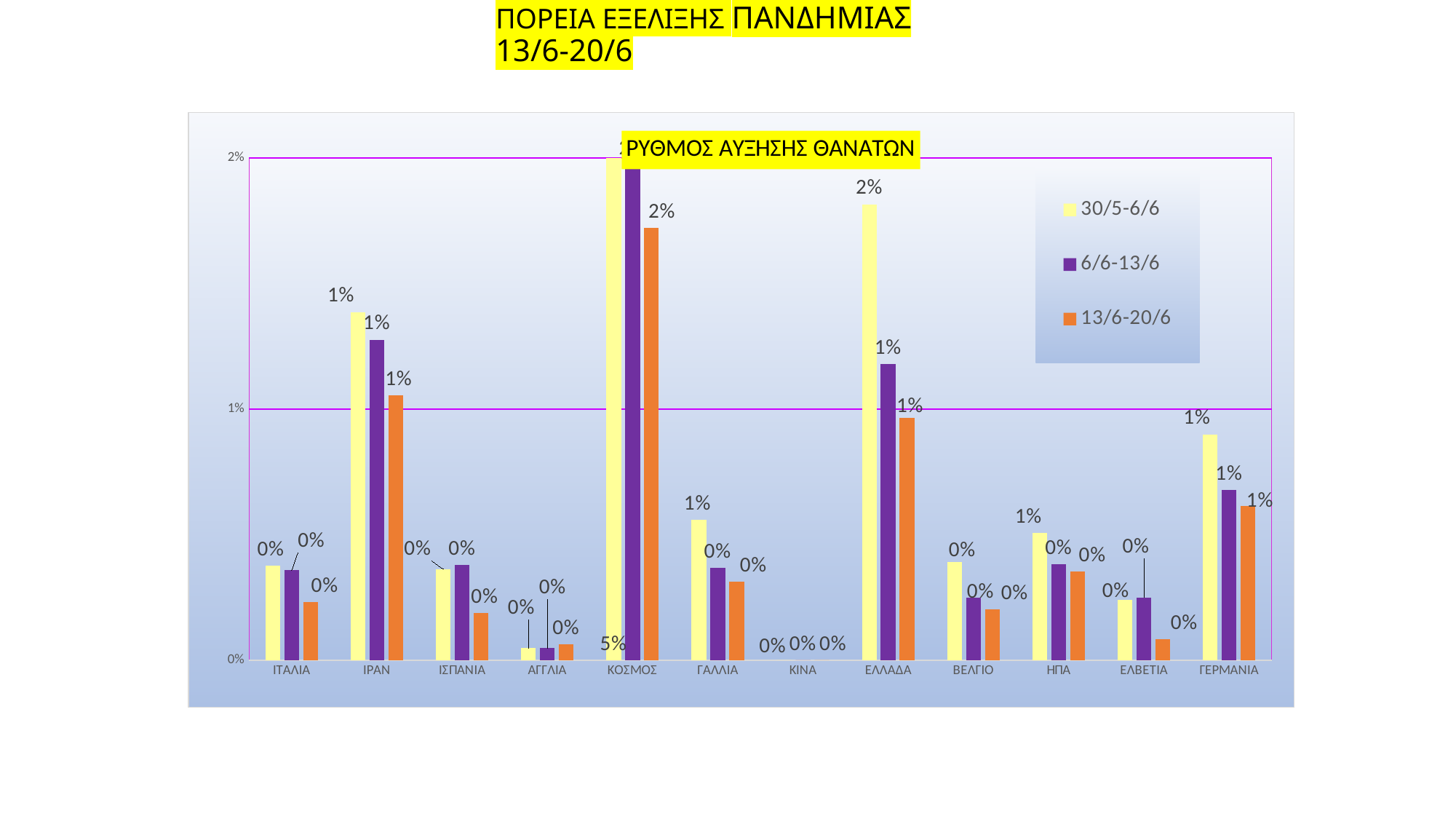
How many series does the legend list? 3 What is the value for ΚΙΝΑ in the 6/6-13/6 series? 0% What is the value for ΕΛΛΑΔΑ in the 30/5-6/6 series? 2% For the 30/5-6/6 series, which is larger: ΙΡΑΝ or ΕΛΛΑΔΑ? ΕΛΛΑΔΑ Which category has the highest value in the 13/6-20/6 series? ΚΟΣΜΟΣ What is the value for ΚΟΣΜΟΣ in the 13/6-20/6 series? 2% Is the value for ΓΕΡΜΑΝΙΑ in the 30/5-6/6 series greater or less than 1%? less What kind of chart is shown on the slide? Bar chart Which category has the lowest values across all three series? ΚΙΝΑ What is the title of the chart? ΡΥΘΜΟΣ ΑΥΞΗΣΗΣ ΘΑΝΑΤΩΝ Is the value for ΙΡΑΝ in the 30/5-6/6 series greater or less than 1%? greater How many countries/categories are shown on the x axis? 12